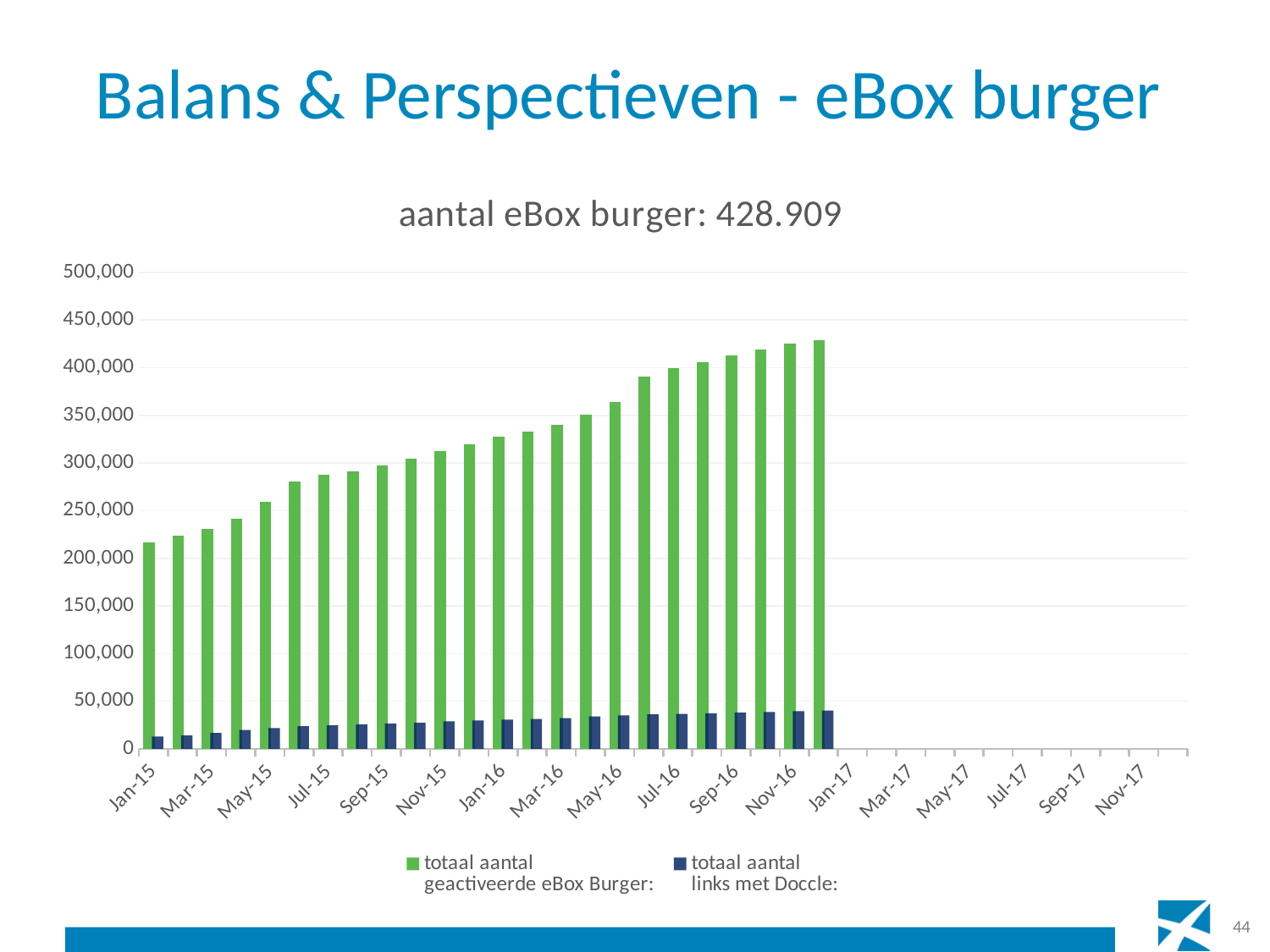
What is the title of the chart? aantal eBox burger: 428.909 Which is larger in Jan-16: 'totaal aantal geactiveerde eBox Burger:' or 'totaal aantal links met Doccle:'? totaal aantal geactiveerde eBox Burger: Is the value for 'totaal aantal geactiveerde eBox Burger:' in Jan-15 greater or less than 200,000? greater How many series does the legend list? 2 Do the values for 'totaal aantal geactiveerde eBox Burger:' rise or fall from Jan-15 to Jan-17? rise Which month has the lowest value for 'totaal aantal geactiveerde eBox Burger:'? Jan-15 How many month labels are shown on the x axis? 18 Which series is shown in green? totaal aantal geactiveerde eBox Burger: What kind of chart is shown on the slide? bar chart